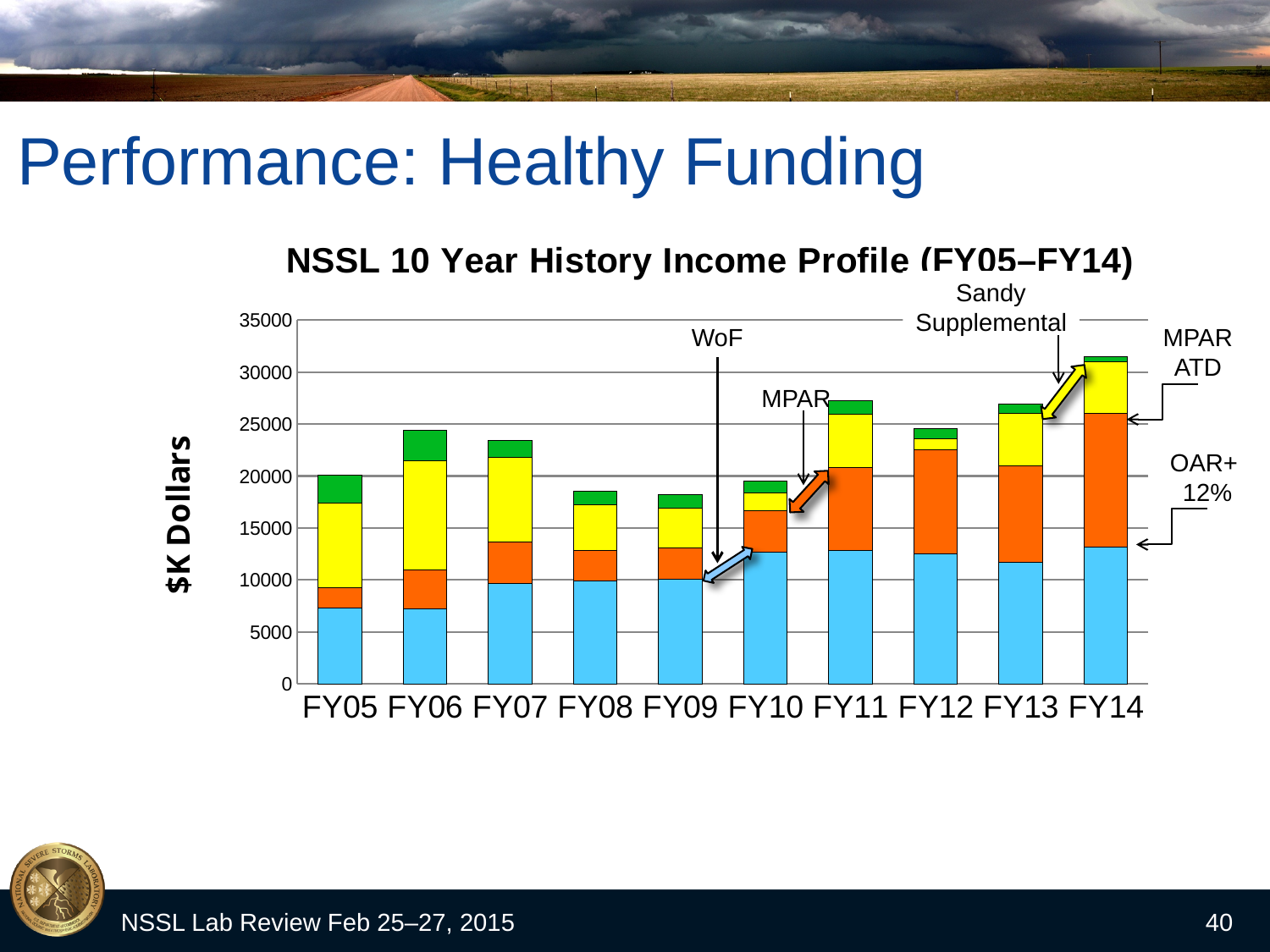
Is the total value for FY13 greater or less than 25000? greater Which has the larger total bar, FY14 or FY05? FY14 Is the total value for FY11 greater or less than 25000? greater What kind of chart is shown on the slide? Stacked bar chart Which fiscal year has the tallest stacked bar in the chart? FY14 Is the total value for FY14 greater or less than 30000? greater How many fiscal years are shown on the x axis of the chart? 10 What is the title of the chart? NSSL 10 Year History Income Profile (FY05–FY14) Do the total bar heights generally rise or fall from FY09 to FY14? rise Which has the larger total bar, FY11 or FY12? FY11